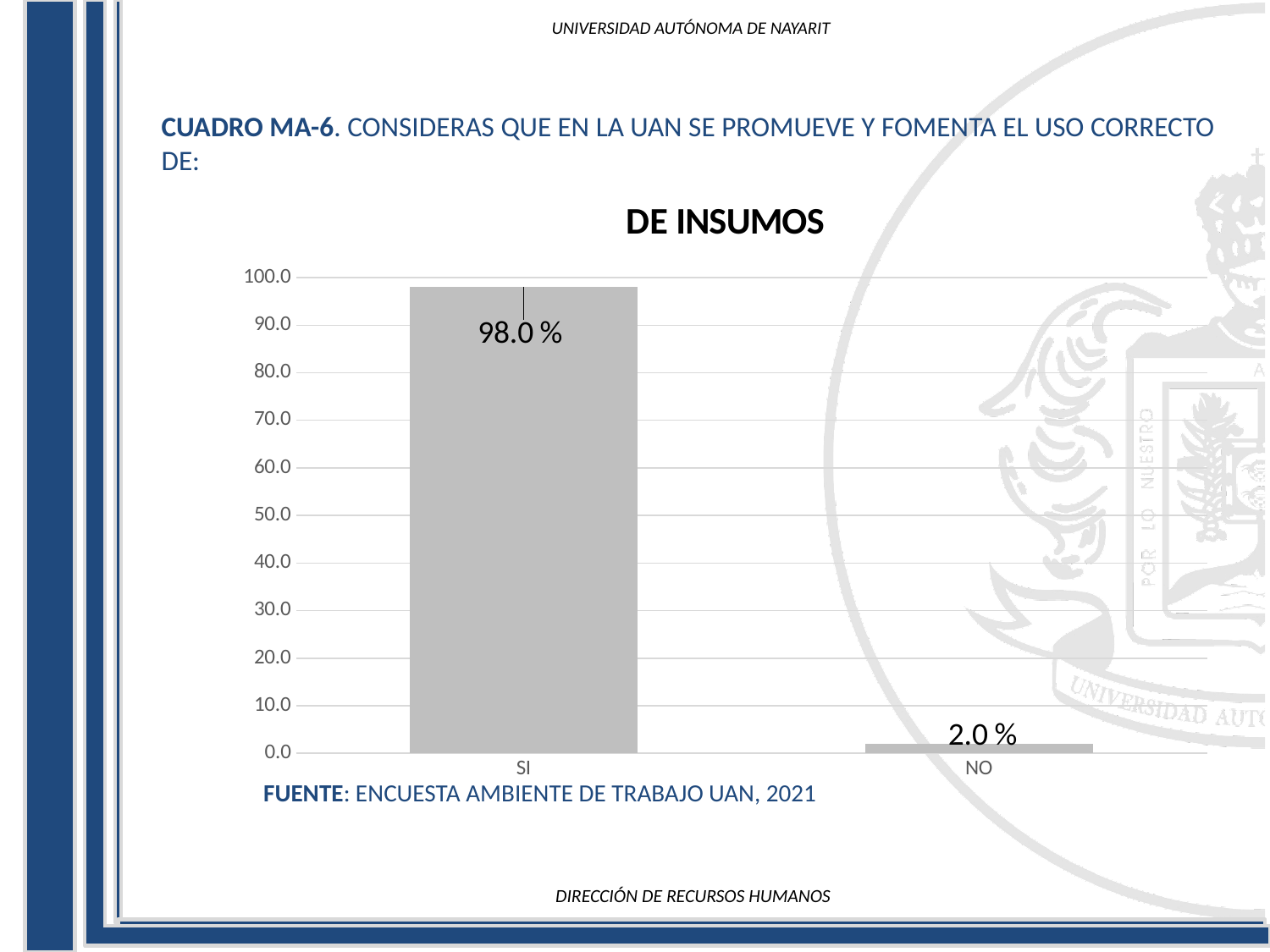
Which category has the highest value? SI What is the difference between the values for SI and NO? 96.0 % What is the title of the chart? DE INSUMOS What is the value for NO? 2.0 % Is the value for NO greater or less than 10.0? less Is the value for SI greater or less than 90.0? greater Which is larger, the value for SI or the value for NO? SI How many categories are shown on the x axis? 2 What kind of chart is shown? bar chart What is the value for SI? 98.0 % Which category has the lowest value? NO What is the highest value shown on the y axis? 100.0